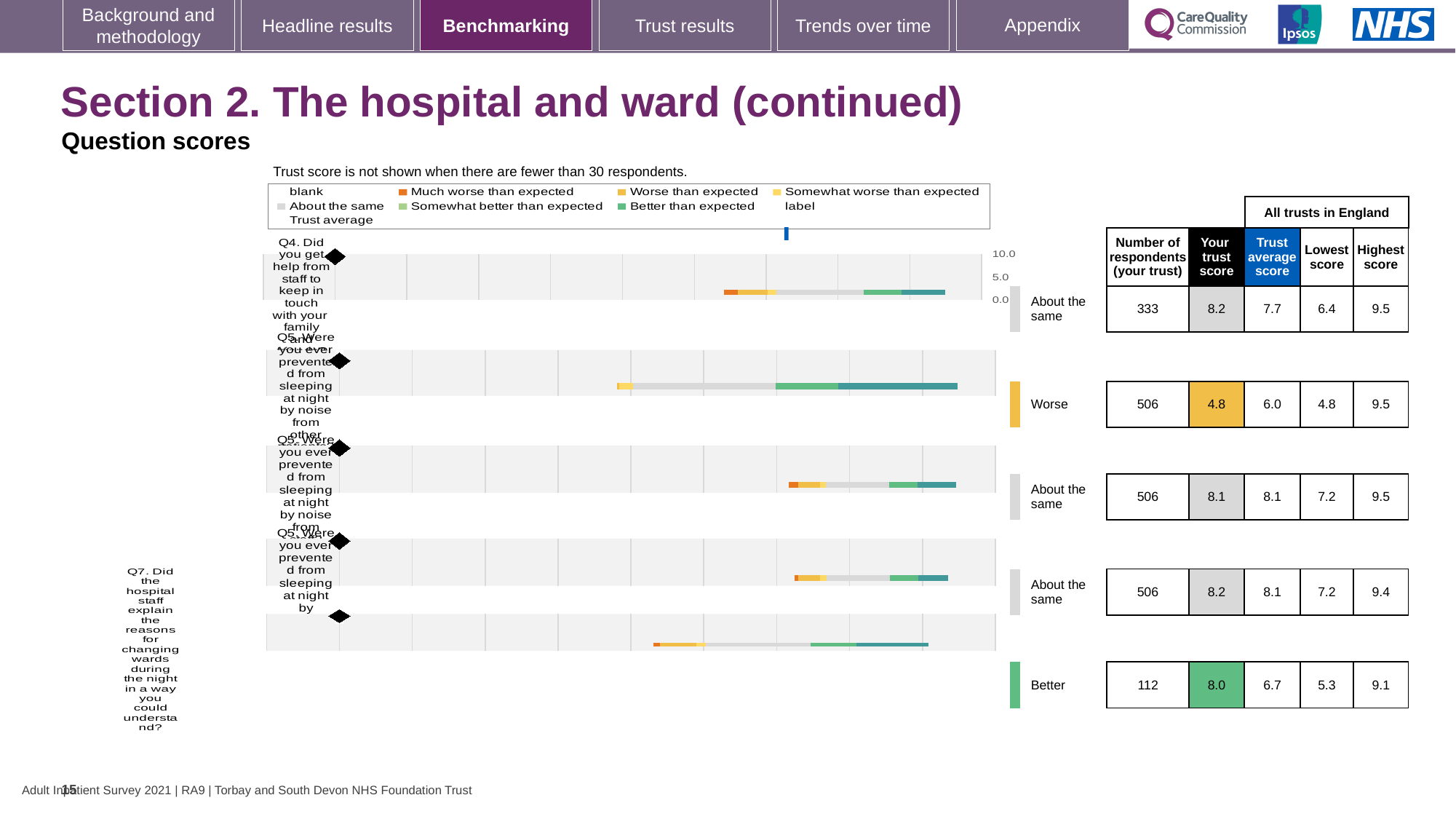
What kind of chart is used to show the question scores on this slide? bar chart How many respondents does the table show for Q4? 333 What note is printed above the chart about when a trust score is not shown? Trust score is not shown when there are fewer than 30 respondents. What is the highest score across all trusts in England for Q7? 9.1 What is the difference between the trust score and the trust average score for Q7? 1.3 How many question bars are plotted in the chart? 5 Which row has the lowest 'Your trust score' in the table? the second row, rated 'Worse' (4.8) How many rows in the table have 506 respondents? 3 What is the difference between the trust score and the trust average score for Q4? 0.5 What is the 'Your trust score' for Q7 (explaining reasons for changing wards during the night)? 8.0 For Q4, which is larger: the 'Your trust score' or the 'Trust average score'? Your trust score What is the 'Your trust score' for Q4 (help from staff to keep in touch with family and friends)? 8.2